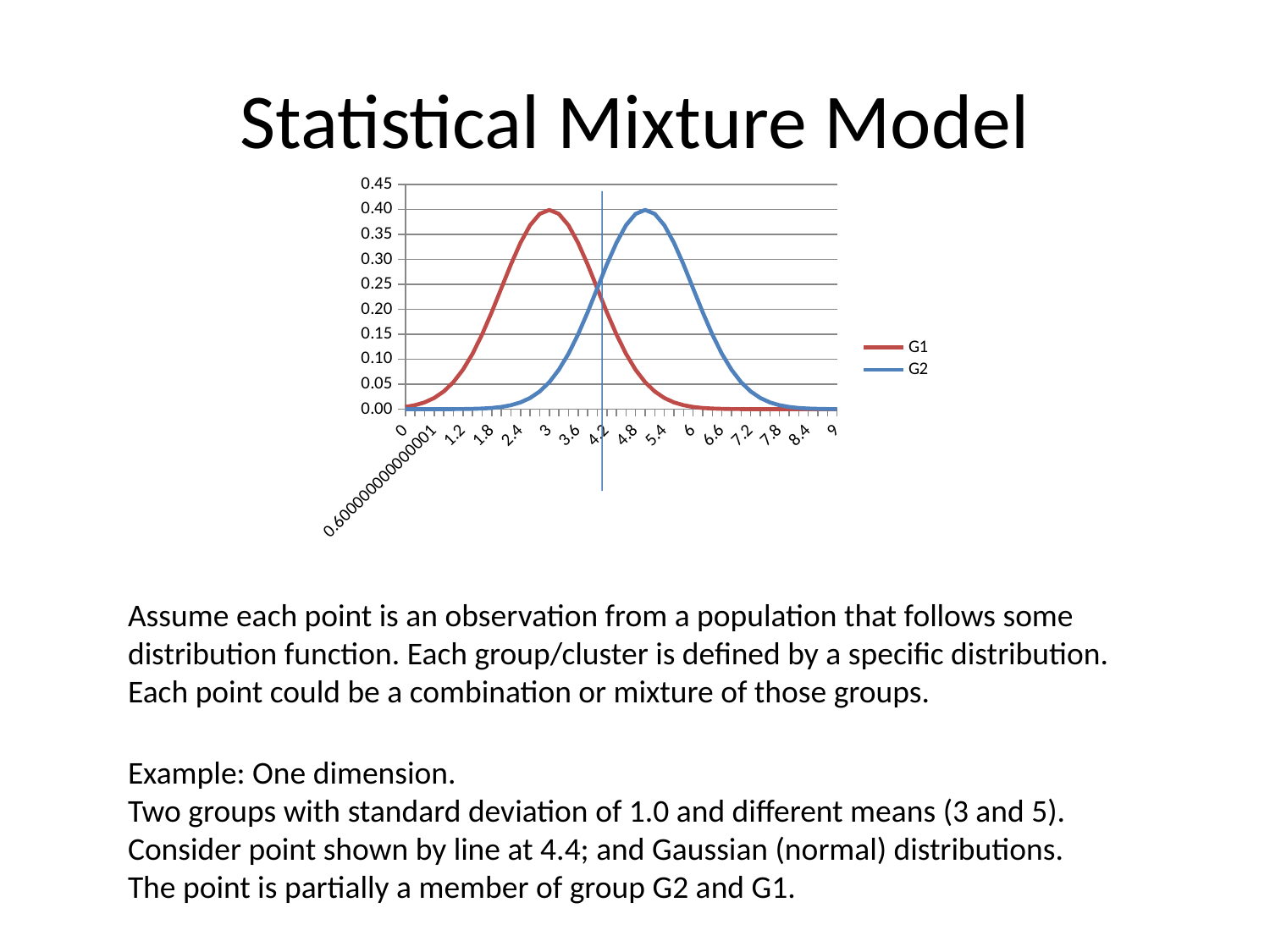
Is the value of G2 at x = 3 greater or less than 0.10? less At x = 6, which series has the larger value, G1 or G2? G2 Which colour is used for the G1 series? red What kind of chart is shown on the slide? line chart Do the values of G1 rise or fall as x increases from 3 to 9? fall Which series reaches its peak at x = 3? G1 Is the value of G2 at x = 5.4 greater or less than 0.30? greater At x = 3, which series has the larger value, G1 or G2? G1 Is the value of G1 at x = 3 greater or less than 0.35? greater Which colour is used for the G2 series? blue How many series does the legend list? 2